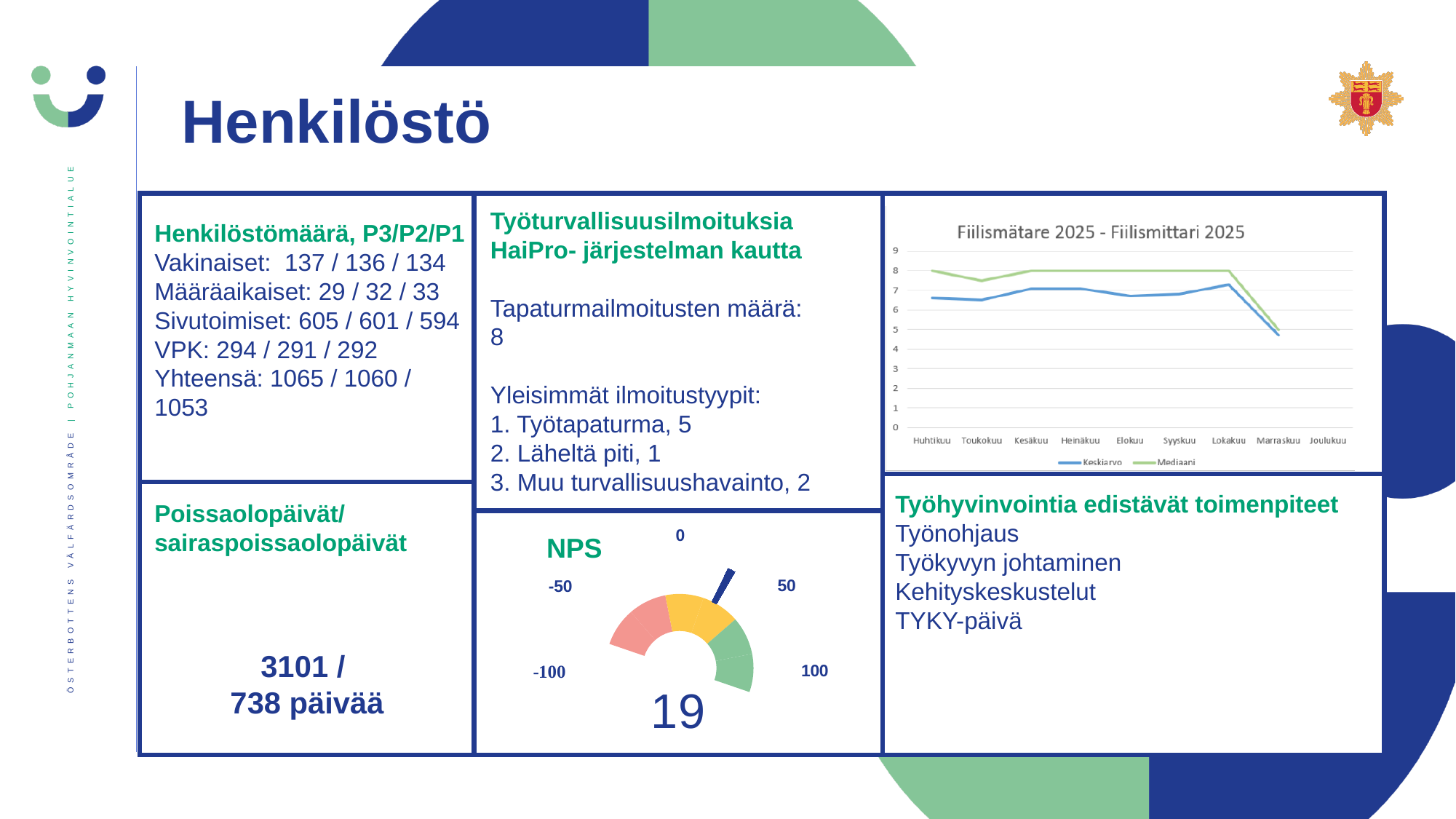
In the 'Fiilismätare 2025 - Fiilismittari 2025' chart, is the Keskiarvo value for Marraskuu greater or less than 6? less In the 'Fiilismätare 2025 - Fiilismittari 2025' chart, do the values rise or fall from Lokakuu to Marraskuu? fall How many month labels are shown on the x axis of the 'Fiilismätare 2025 - Fiilismittari 2025' chart? 9 How many series does the legend of the 'Fiilismätare 2025 - Fiilismittari 2025' chart list? 2 What kind of chart is the 'Fiilismätare 2025 - Fiilismittari 2025' chart? line chart In the 'Fiilismätare 2025 - Fiilismittari 2025' chart, is the Keskiarvo value for Huhtikuu greater or less than 7? less What are the two legend entries in the 'Fiilismätare 2025 - Fiilismittari 2025' chart? Keskiarvo and Mediaani What is the title of the line chart on the slide? Fiilismätare 2025 - Fiilismittari 2025 In the 'Fiilismätare 2025 - Fiilismittari 2025' chart, which month has the lowest Keskiarvo value? Marraskuu In the 'Fiilismätare 2025 - Fiilismittari 2025' chart, is the Mediaani value for Lokakuu greater or less than 6? greater In the 'Fiilismätare 2025 - Fiilismittari 2025' chart, which series has the higher value in Huhtikuu, Keskiarvo or Mediaani? Mediaani What value is shown on the NPS gauge chart? 19